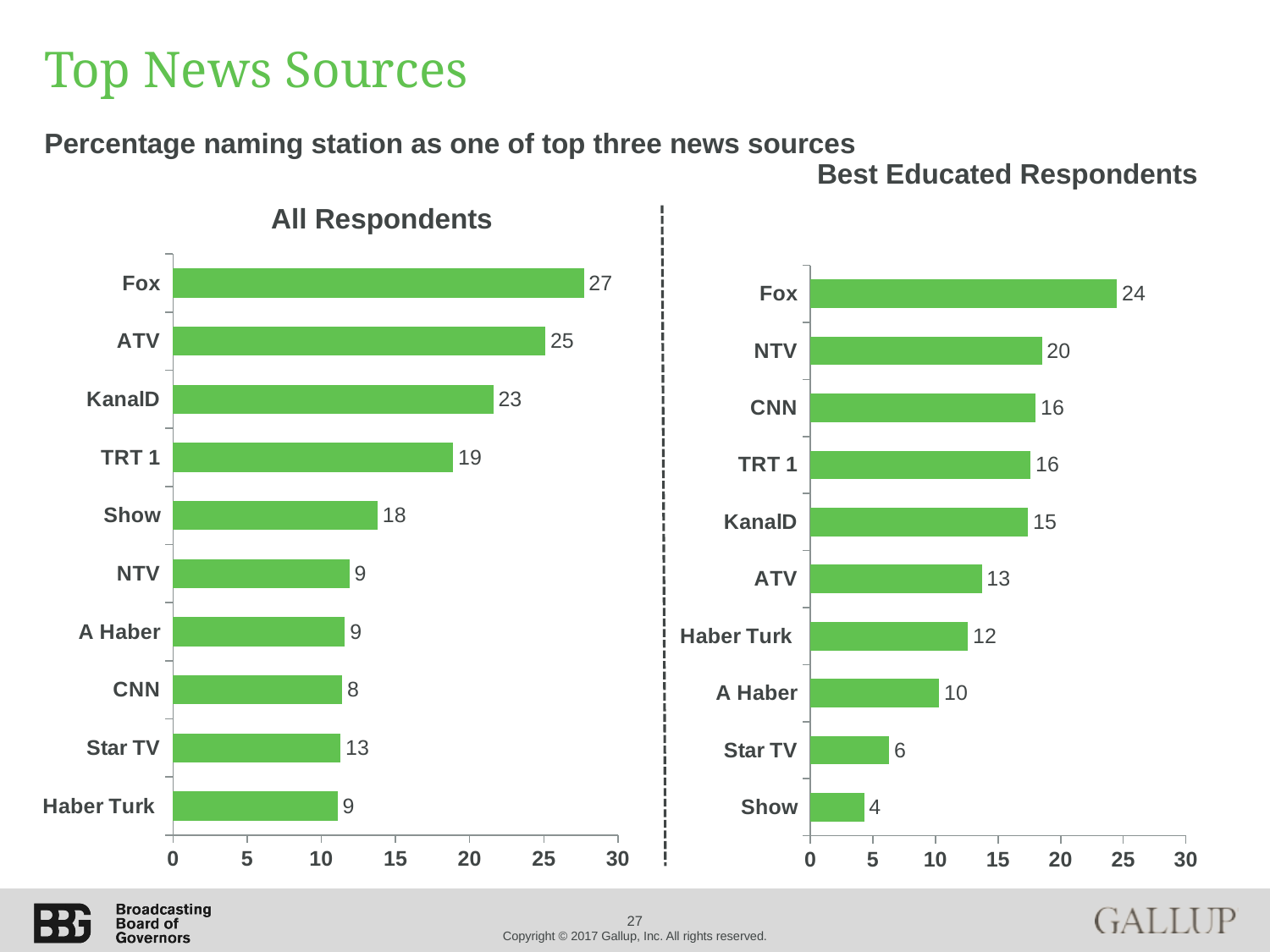
In the Best Educated Respondents chart, what is the difference between the values for Fox and Show? 20 In the Best Educated Respondents chart, what is the value for Star TV? 6 What kind of chart is the All Respondents chart? Bar chart In the Best Educated Respondents chart, which is larger, the value for KanalD or the value for ATV? KanalD How many stations are shown in the Best Educated Respondents chart? 10 In the Best Educated Respondents chart, which station has the lowest value? Show In the All Respondents chart, is the value for KanalD greater or less than 20? greater In the Best Educated Respondents chart, what is the value for NTV? 20 In the All Respondents chart, what is the difference between the values for Fox and ATV? 2 In the All Respondents chart, what percentage named Fox as one of their top three news sources? 27 In the All Respondents chart, which station has the highest value? Fox What is the title of the chart on the left side of the slide? All Respondents